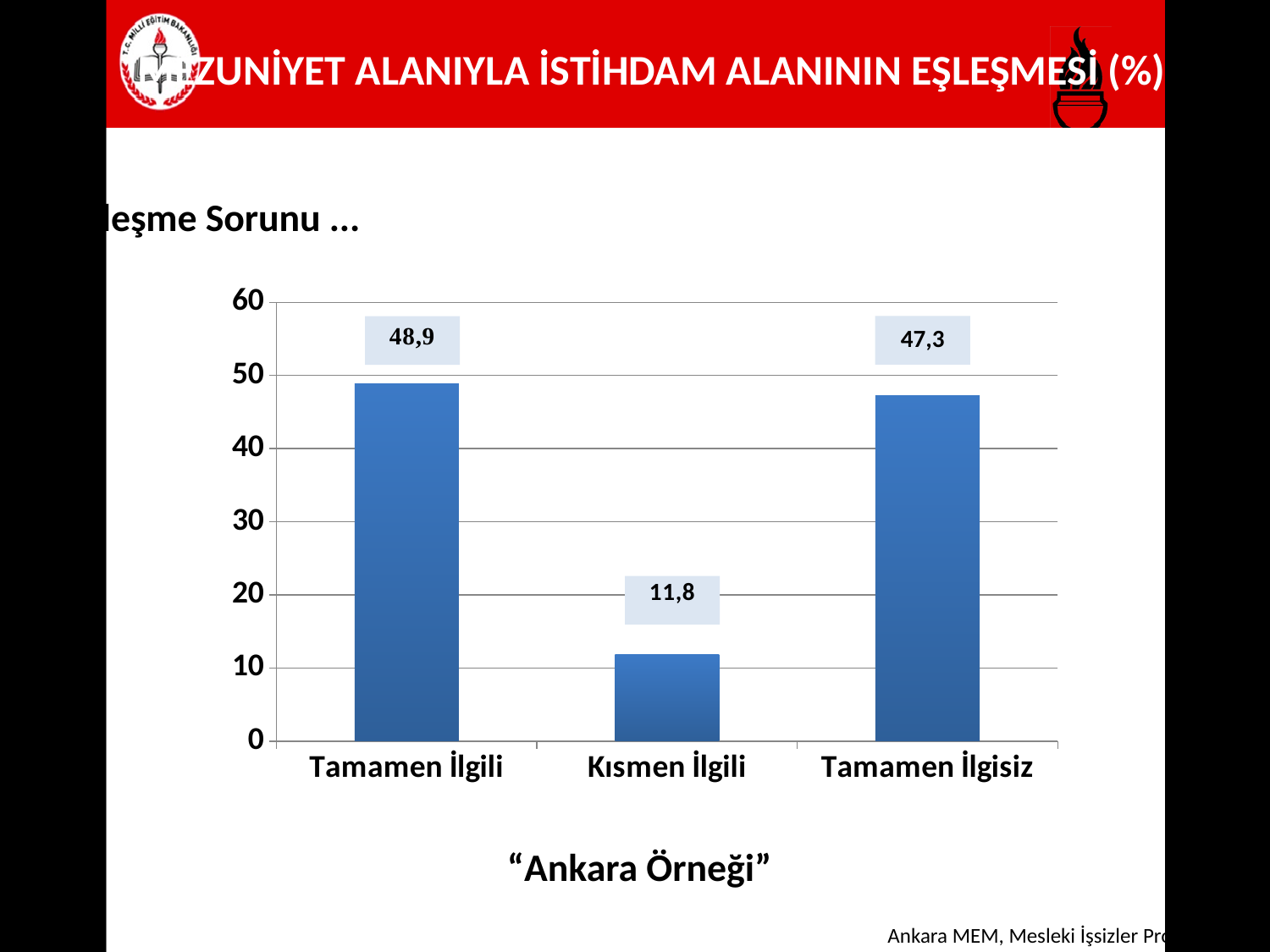
What is the difference between the values for Tamamen İlgili and Kısmen İlgili? 37,1 What is the difference between the values for Tamamen İlgisiz and Kısmen İlgili? 35,5 How many categories are shown on the x axis? 3 Which category has the highest value? Tamamen İlgili What is the value for Tamamen İlgisiz? 47,3 What kind of chart is shown on the slide? bar chart What is the value for Tamamen İlgili? 48,9 Which is larger, the value for Kısmen İlgili or the value for Tamamen İlgisiz? Tamamen İlgisiz Is the value for Kısmen İlgili greater or less than 20? less Is the value for Tamamen İlgisiz greater or less than 40? greater What is the value for Kısmen İlgili? 11,8 Which category has the lowest value? Kısmen İlgili